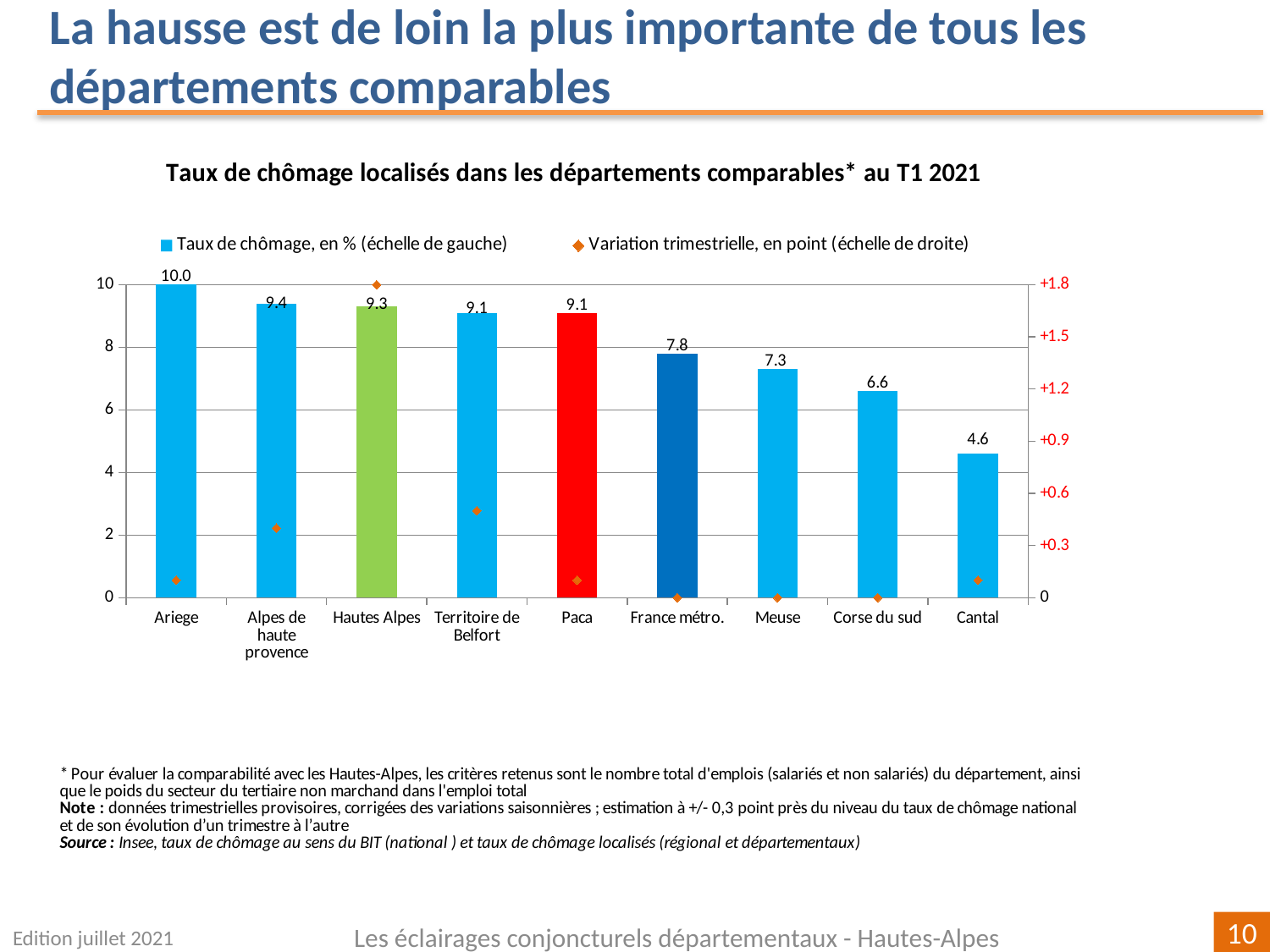
Which category has the highest unemployment rate bar? Ariege What is the unemployment rate shown for Cantal? 4.6 What is the unemployment rate (Taux de chômage) shown for Ariege? 10.0 How many series does the legend list? 2 Which category's bar is coloured red? Paca What is the difference between the unemployment rates of Ariege and Cantal? 5.4 How many departments/categories are shown on the x axis? 9 Which category has the lowest unemployment rate bar? Cantal What is the unemployment rate shown for France métro.? 7.8 Is the quarterly variation for Alpes de haute provence greater or less than +0.6? less Is the quarterly variation (Variation trimestrielle) for Hautes Alpes greater or less than +1.5? greater Which has the higher unemployment rate, Meuse or Corse du sud? Meuse